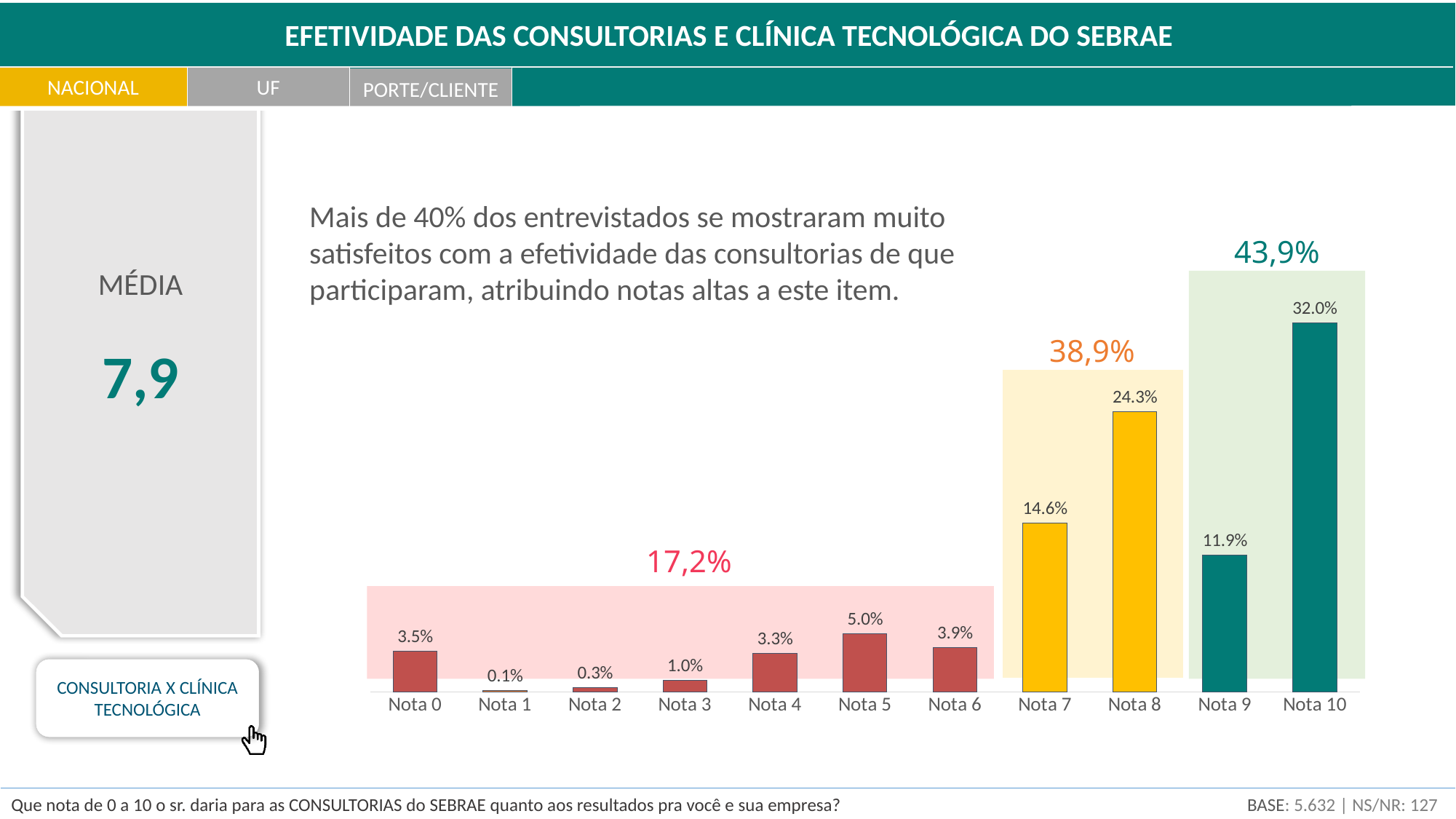
How many categories (notas) are shown on the x axis? 11 What kind of chart is shown on the slide? Bar chart Which category has the highest value? Nota 10 What is the value for Nota 1? 0.1% What is the value for Nota 10? 32.0% Which category has the lowest value? Nota 1 What is the value for Nota 8? 24.3% What is the average (MÉDIA) shown on the left of the slide? 7,9 What is the combined share shown for the group Nota 9 and Nota 10? 43,9% What is the difference between the values for Nota 10 and Nota 8? 7.7% What is the value for Nota 5? 5.0% Which is larger, the value for Nota 7 or the value for Nota 9? Nota 7